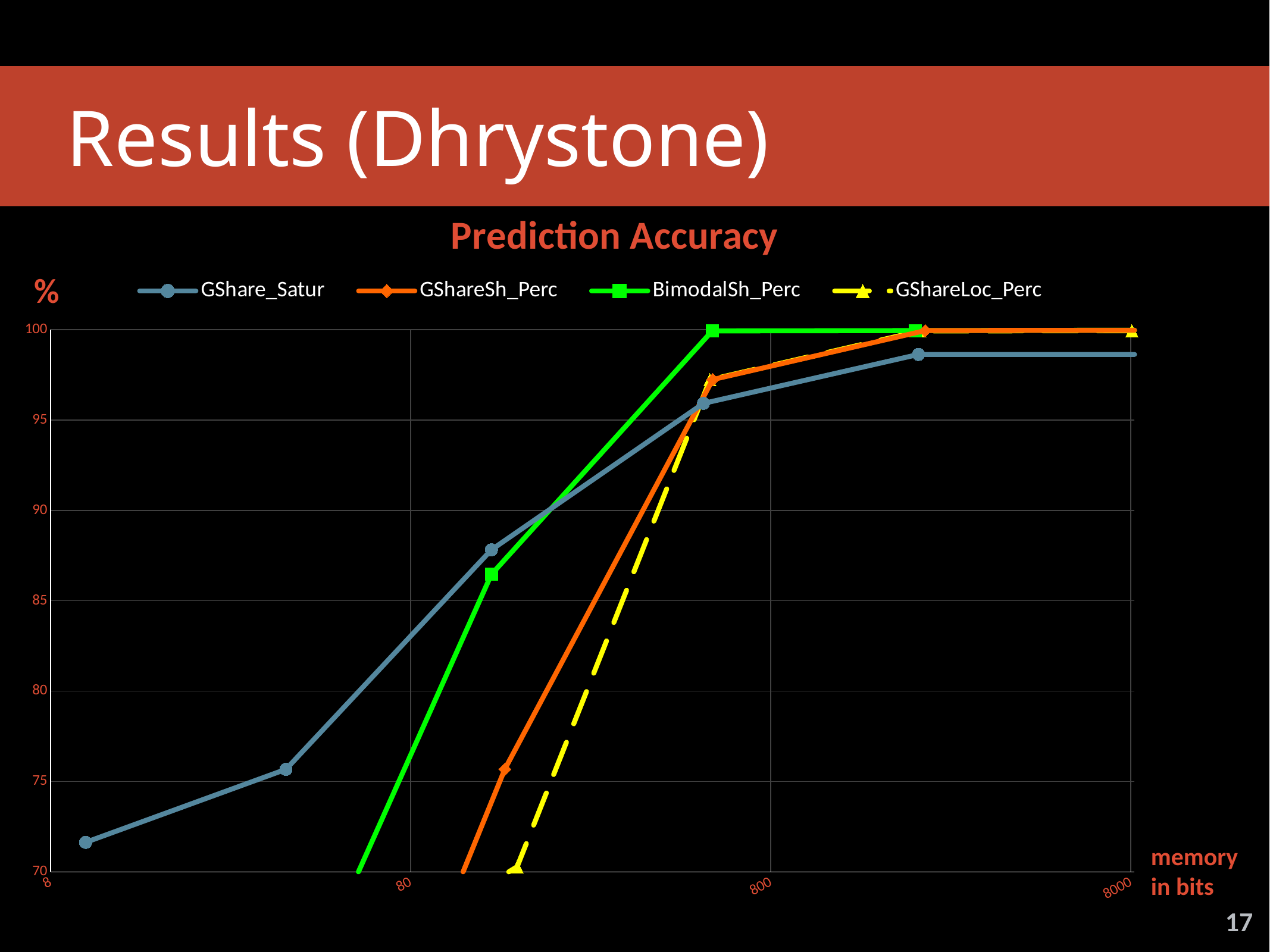
Is the highest value reached by GShare_Satur greater or less than 95? greater Is the lowest marked point of GShareSh_Perc greater or less than 80? less What is the label of the x axis? memory in bits Is the lowest plotted value of GShare_Satur greater or less than 75? less Do the values of GShare_Satur rise or fall as memory in bits increases? rise What is the title of the chart? Prediction Accuracy What kind of chart is shown on the slide? line chart At the x position just before 800, which is larger: BimodalSh_Perc or GShare_Satur? BimodalSh_Perc Do the values of BimodalSh_Perc rise or fall as memory in bits increases? rise How many series does the legend list? 4 Which series has the lowest value at the leftmost x position (8)? GShare_Satur